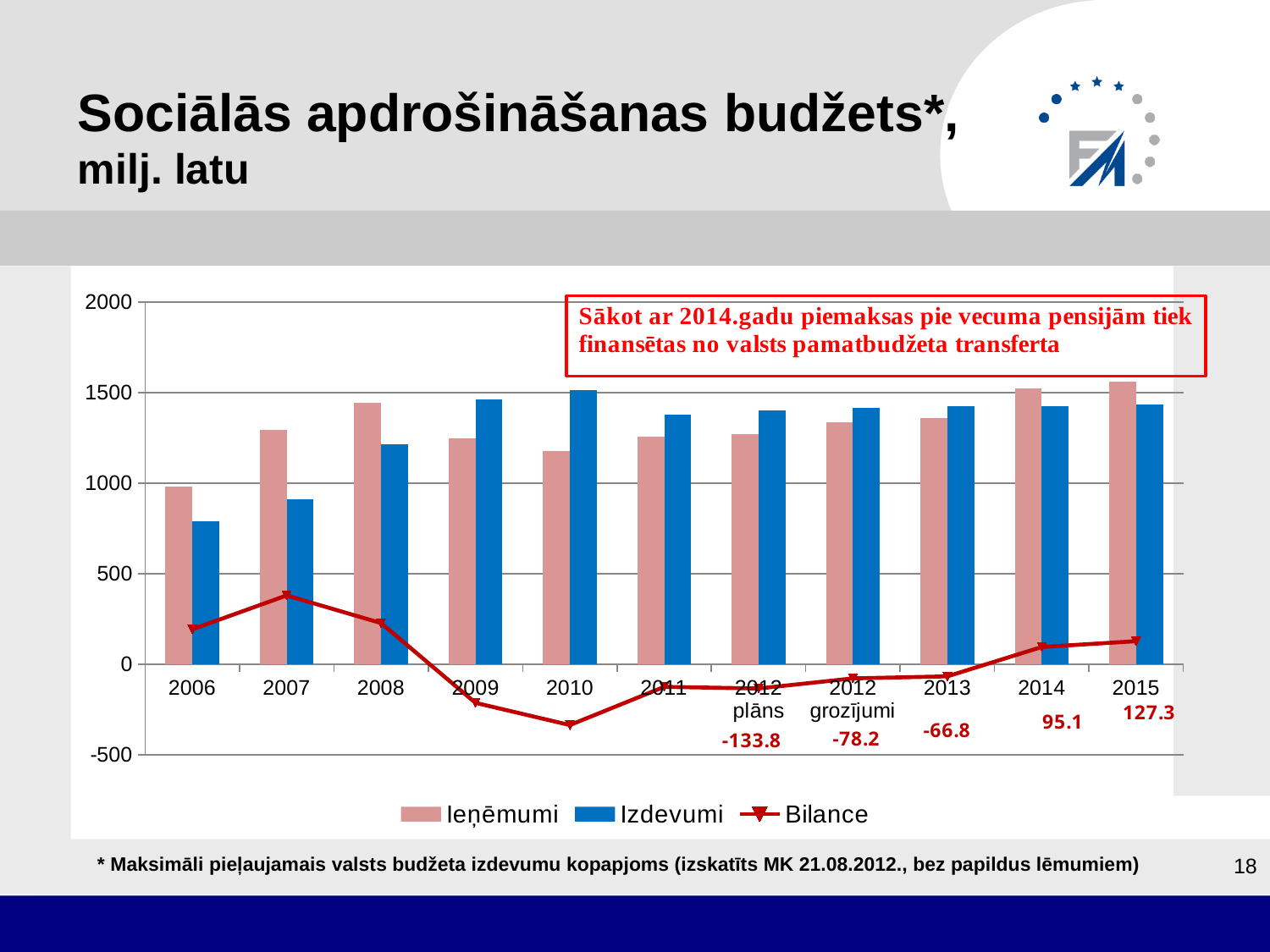
What is the Bilance value for 2015? 127.3 What is the Bilance value for 2012 plāns? -133.8 What is the difference between the Bilance values for 2015 and 2014? 32.2 What is the Bilance value for 2012 grozījumi? -78.2 How many series does the legend list? 3 Which is larger, the Bilance value for 2013 or for 2014? 2014 Is the Izdevumi value for 2006 greater or less than 1000? less How many categories are shown on the x axis? 11 What kind of chart is shown on the slide? Combined bar and line chart Is the Ieņēmumi value for 2010 greater or less than 1500? less What is the Bilance value for 2014? 95.1 Among the labelled Bilance values, which category has the lowest value? 2012 plāns